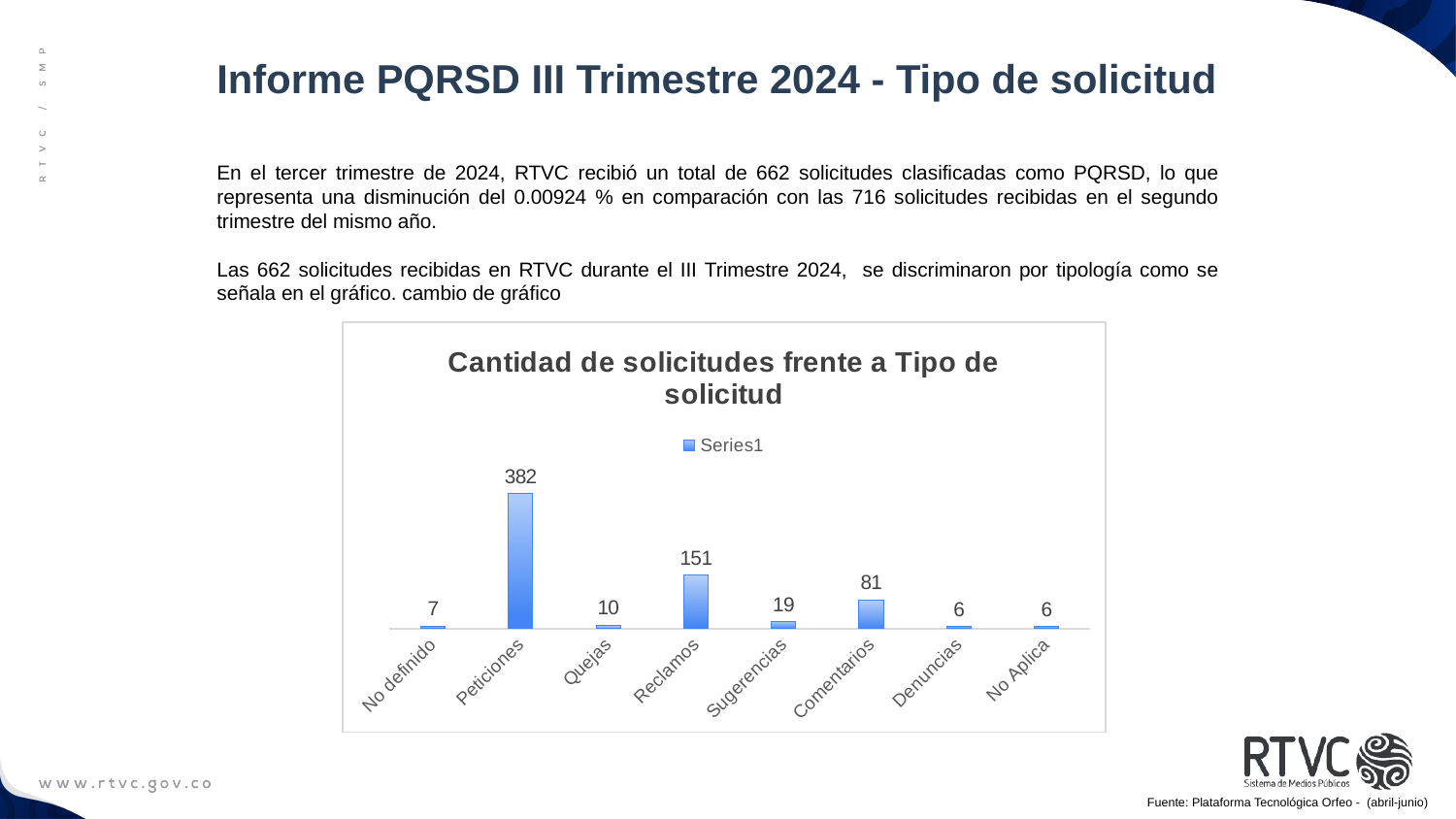
What is the value for Reclamos? 151 What is the value for Peticiones? 382 What is the difference between the values for Quejas and No definido? 3 Which category has the highest value? Peticiones What is the value for Comentarios? 81 Which is larger, the value for Comentarios or the value for Sugerencias? Comentarios What kind of chart is shown? Bar chart What is the title of the chart? Cantidad de solicitudes frente a Tipo de solicitud What is the difference between the values for Peticiones and Reclamos? 231 How many series does the legend list? 1 How many categories are shown on the x axis? 8 What is the value for Sugerencias? 19